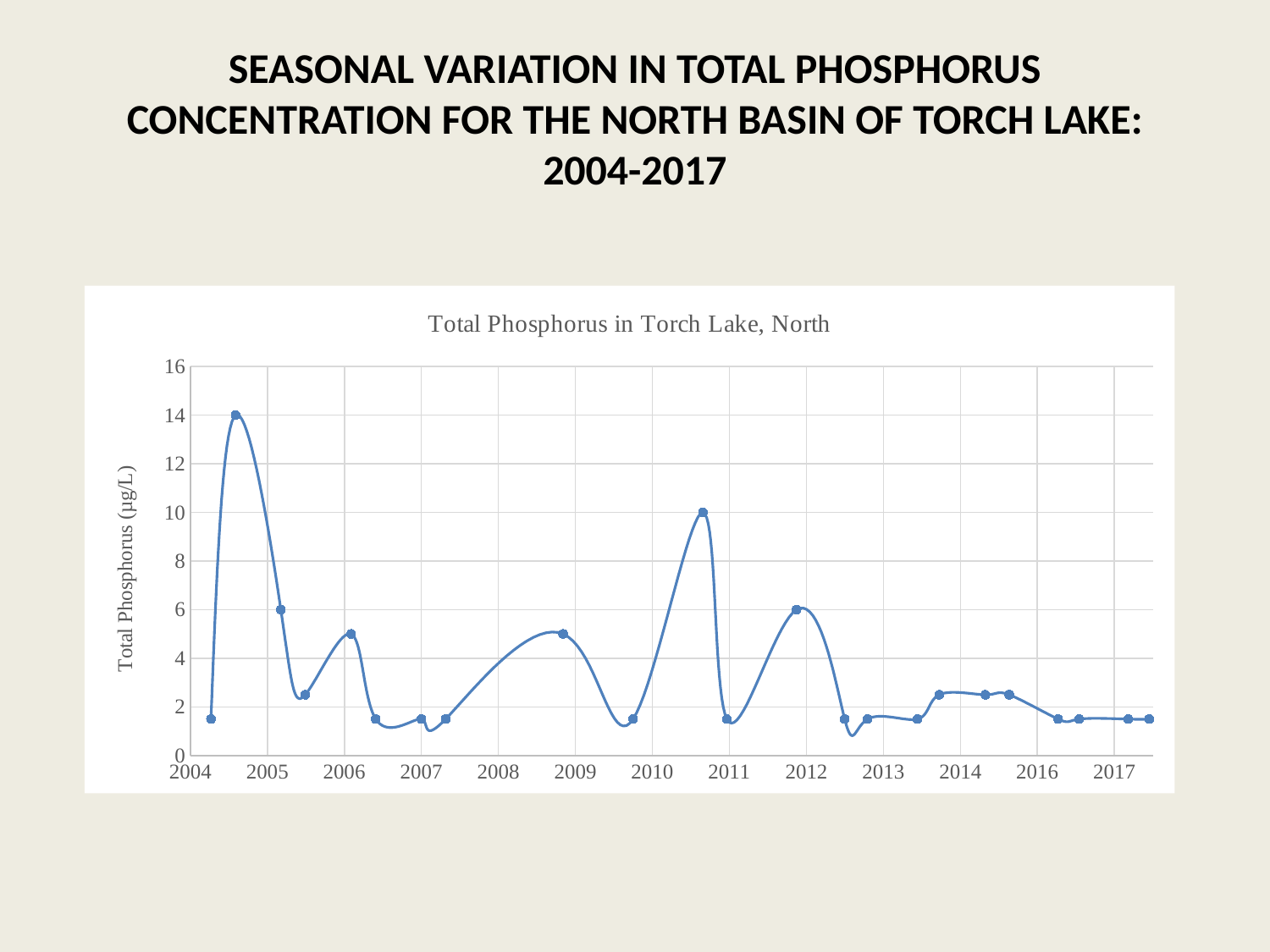
Which peak is higher, the one in 2004 or the one in 2010? 2004 What is the label on the vertical axis? Total Phosphorus (µg/L) Are the values plotted in 2017 greater or less than 2? less What kind of chart is shown on the slide? line chart What is the highest total phosphorus value plotted on the chart? 14 What is the title printed inside the chart area? Total Phosphorus in Torch Lake, North What is the difference between the highest peak (in 2004) and the peak in 2010? 4 Do the peak values generally rise or fall from 2004 to 2017? fall Is the peak plotted in early 2006 greater or less than 4? greater What is the value of the peak plotted near the end of 2011/start of 2012? 6 What is the value of the peak plotted in late 2010? 10 What is the maximum value shown on the vertical axis? 16